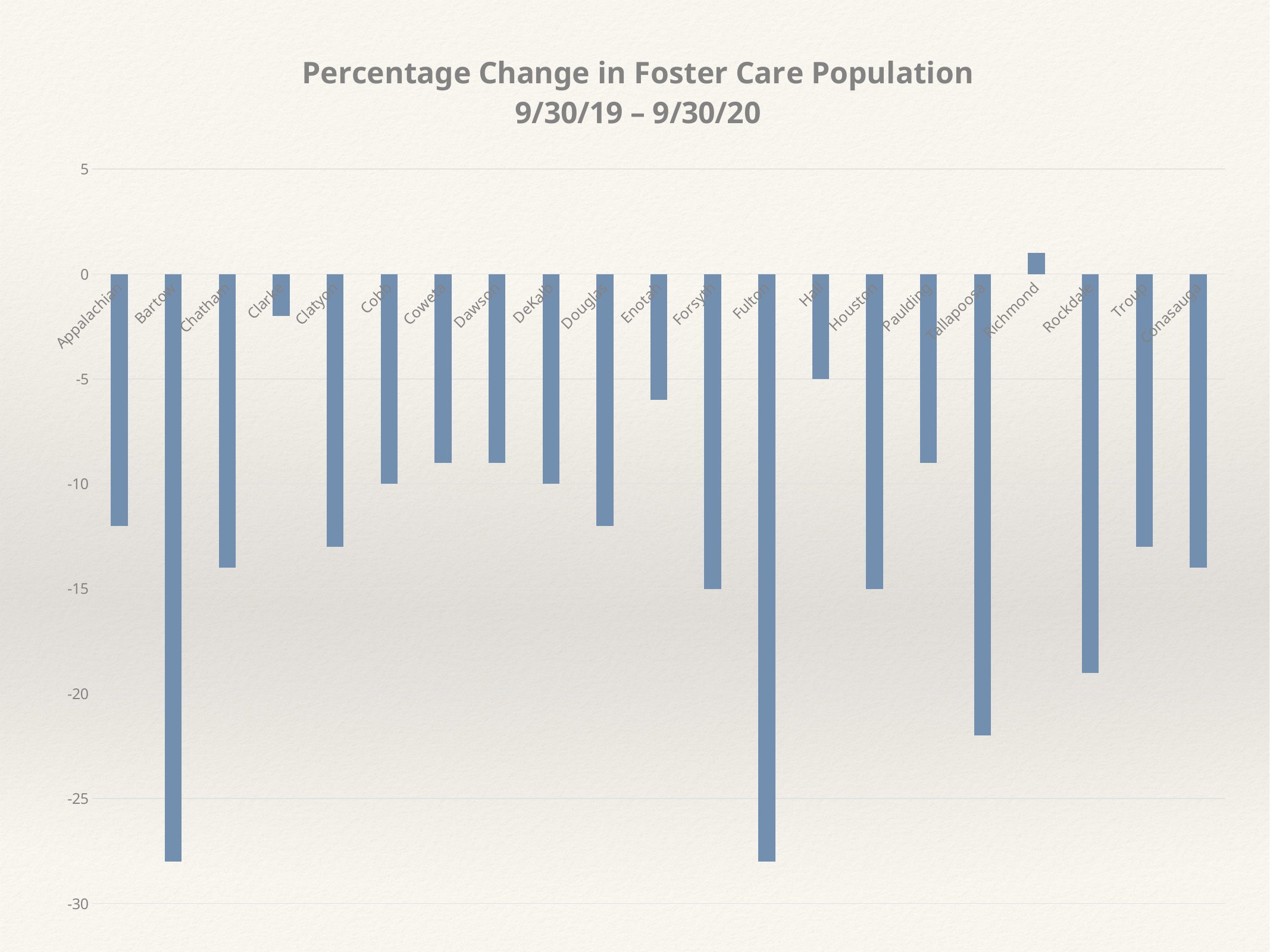
Is the value for Rockdale greater or less than -15? less How many categories (regions) are plotted on the x axis? 21 What kind of chart is shown on the slide? bar chart Which has the larger value, Clarke or Hall? Clarke Which is the only category with a positive percentage change? Richmond Is the value for Clarke greater or less than -5? greater Is the value for Enotah greater or less than -10? greater Which category has the highest value on the chart? Richmond What is the title of the chart? Percentage Change in Foster Care Population 9/30/19 – 9/30/20 Which has the larger value, Rockdale or Tallapoosa? Rockdale